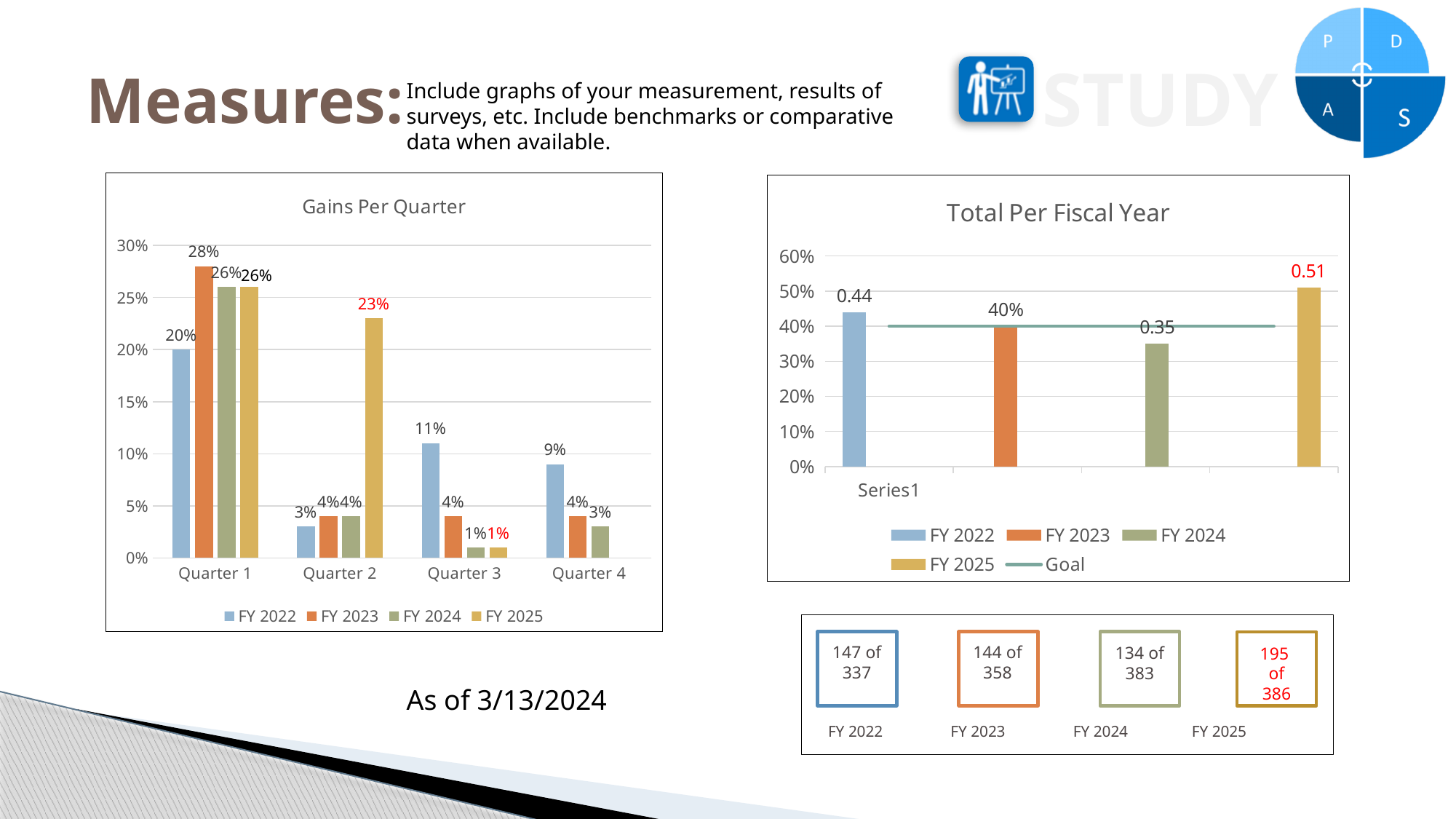
In the Total Per Fiscal Year chart, how many entries does the legend list? 5 In the Gains Per Quarter chart, how many series does the legend list? 4 What kind of chart is the Total Per Fiscal Year chart? combination bar and line chart In the Gains Per Quarter chart, how many quarters are shown on the x axis? 4 In the Gains Per Quarter chart, which series has the highest value in Quarter 3? FY 2022 In the Total Per Fiscal Year chart, is the value for FY 2022 greater or less than 40%? greater In the Gains Per Quarter chart, what is the value for FY 2023 in Quarter 1? 28% In the Gains Per Quarter chart, does the FY 2022 value fall or rise from Quarter 3 to Quarter 4? fall In the Gains Per Quarter chart, what is the difference between the FY 2022 and FY 2023 values in Quarter 1? 8% In the Gains Per Quarter chart, what is the value for FY 2025 in Quarter 2? 23% In the Total Per Fiscal Year chart, what is the value for FY 2025? 0.51 In the Total Per Fiscal Year chart, which fiscal year has the lowest value? FY 2024